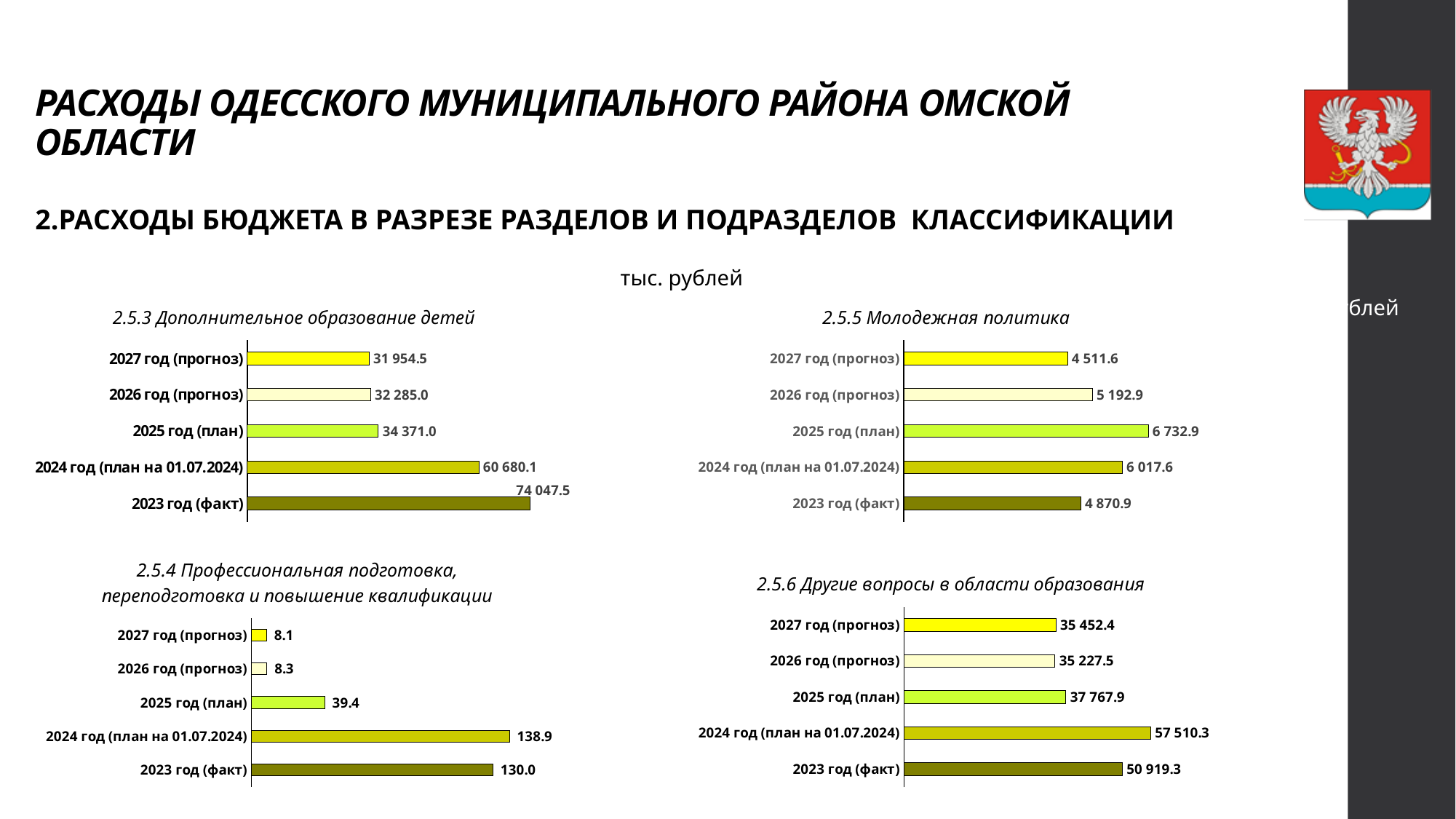
In the chart '2.5.4 Профессиональная подготовка, переподготовка и повышение квалификации', what is the value for 2024 год (план на 01.07.2024)? 138.9 In the chart '2.5.5 Молодежная политика', what is the value for 2025 год (план)? 6 732.9 In the chart '2.5.4 Профессиональная подготовка, переподготовка и повышение квалификации', what is the difference between 2024 год (план на 01.07.2024) and 2023 год (факт)? 8.9 In the chart '2.5.5 Молодежная политика', which category has the highest value? 2025 год (план) How many categories does the chart '2.5.6 Другие вопросы в области образования' show? 5 In the chart '2.5.3 Дополнительное образование детей', which category has the lowest value? 2027 год (прогноз) In the chart '2.5.3 Дополнительное образование детей', what is the difference between 2023 год (факт) and 2024 год (план на 01.07.2024)? 13 367.4 In the chart '2.5.6 Другие вопросы в области образования', what is the value for 2026 год (прогноз)? 35 227.5 In the chart '2.5.3 Дополнительное образование детей', what is the value for 2023 год (факт)? 74 047.5 In the chart '2.5.5 Молодежная политика', which is larger: 2023 год (факт) or 2026 год (прогноз)? 2026 год (прогноз) In the chart '2.5.6 Другие вопросы в области образования', which category has the highest value? 2024 год (план на 01.07.2024) What type of chart is '2.5.3 Дополнительное образование детей'? Bar chart